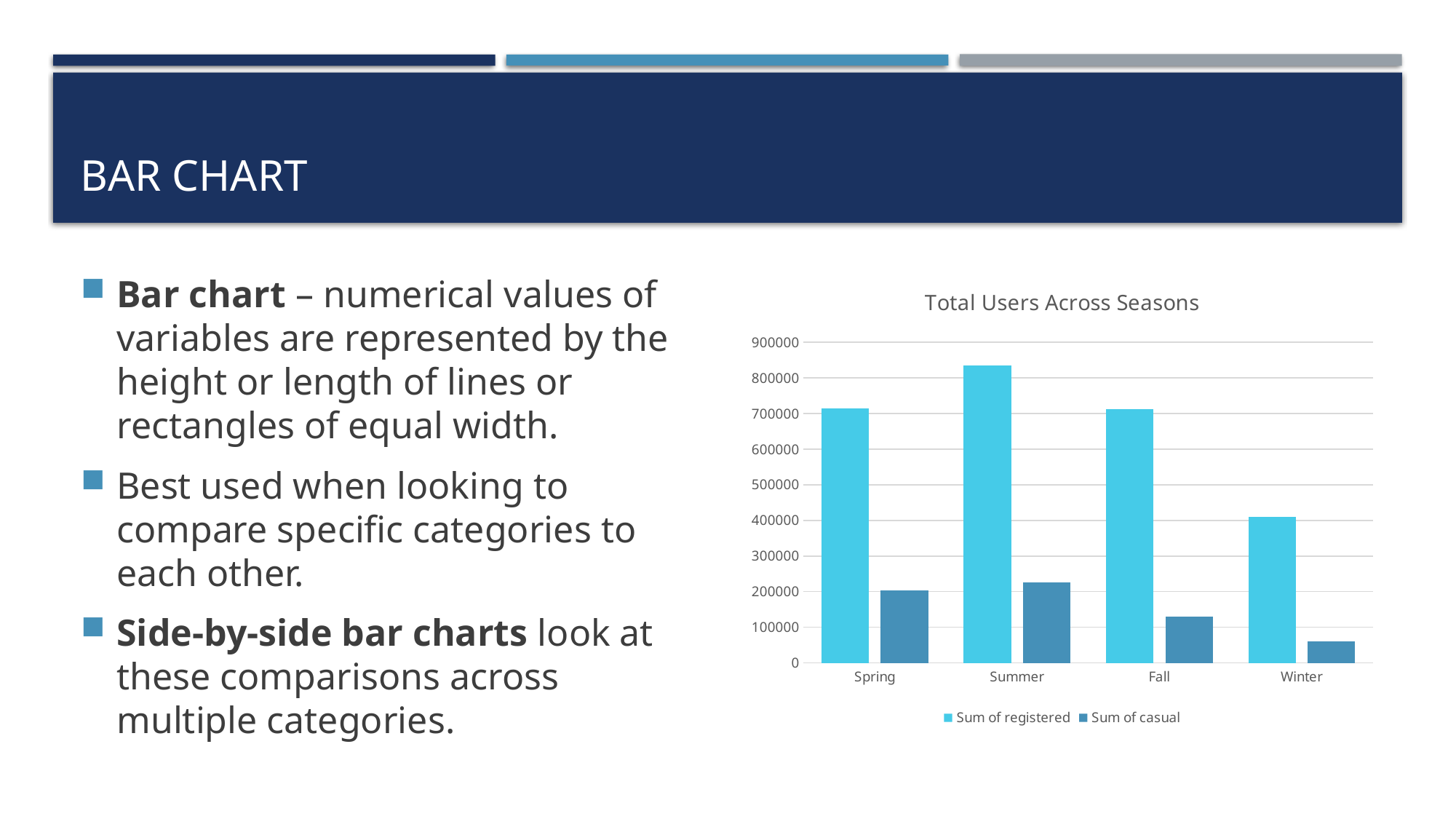
Which is larger, Sum of registered for Summer or Sum of registered for Winter? Summer Which season has the highest value for Sum of registered? Summer What is the title of the chart? Total Users Across Seasons How many seasons are shown on the x axis? 4 How many series does the legend list? 2 Do the Sum of casual values rise or fall from Summer to Winter? fall Which season has the lowest value for Sum of casual? Winter What kind of chart is shown on the slide? bar chart Is the value for Sum of registered in Winter greater or less than 500000? less Is the value for Sum of casual in Winter greater or less than 100000? less Is the value for Sum of registered in Summer greater or less than 800000? greater